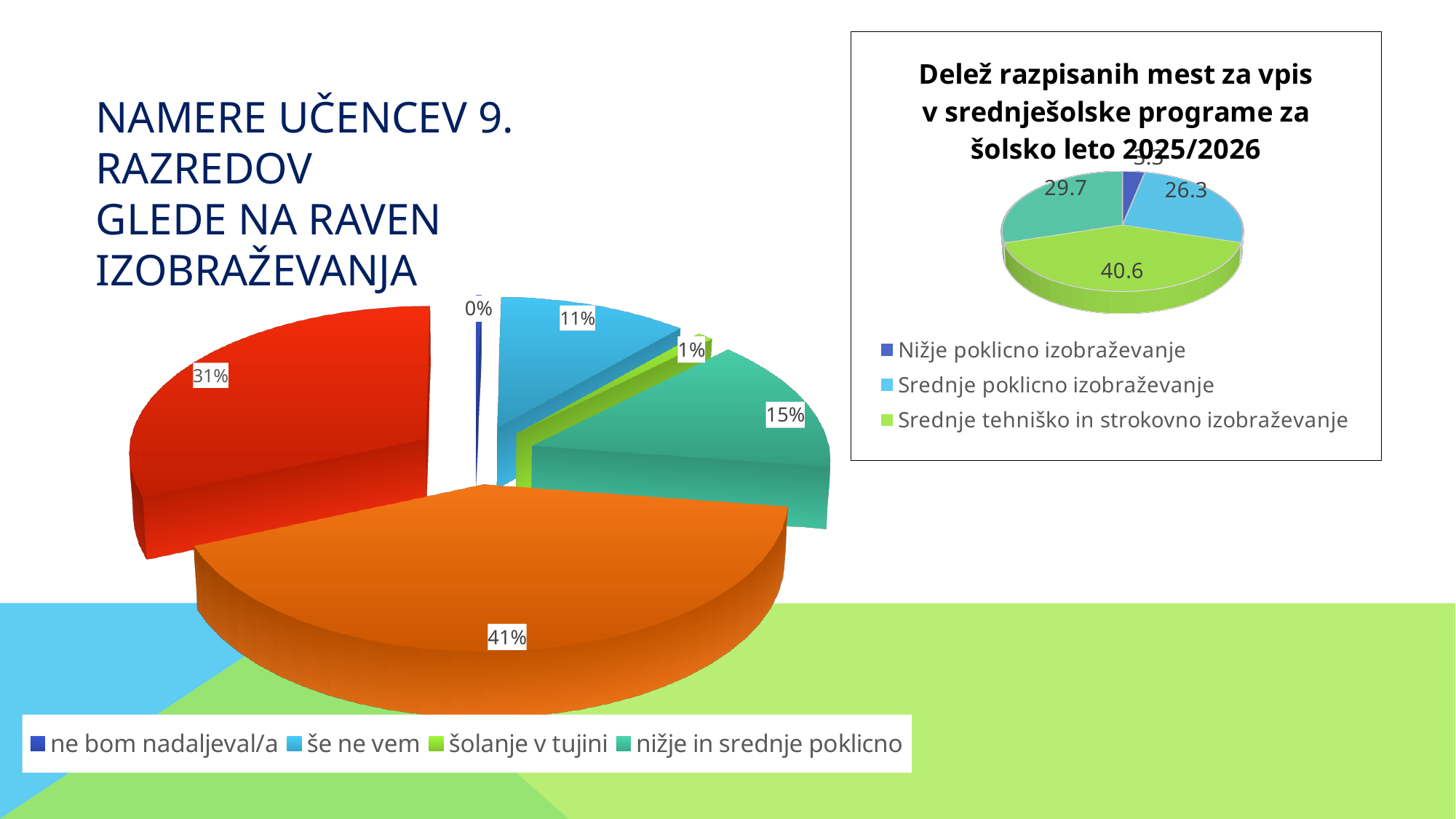
On the chart 'Delež razpisanih mest za vpis v srednješolske programe za šolsko leto 2025/2026', what value is shown for 'Srednje tehniško in strokovno izobraževanje'? 40.6 On the left chart (Namere učencev 9. razredov), what percentage is shown for 'ne bom nadaljeval/a'? 0% On the left chart (Namere učencev 9. razredov), what percentage is shown for 'še ne vem'? 11% What kind of chart is the chart titled 'Delež razpisanih mest za vpis v srednješolske programe za šolsko leto 2025/2026'? pie chart On the chart 'Delež razpisanih mest za vpis v srednješolske programe za šolsko leto 2025/2026', what value is shown for 'Srednje poklicno izobraževanje'? 26.3 On the left chart (Namere učencev 9. razredov), what is the difference between 'nižje in srednje poklicno' and 'še ne vem'? 4% On the left chart (Namere učencev 9. razredov), what is the percentage shown on the largest slice? 41% On the left chart (Namere učencev 9. razredov), what percentage is shown for 'nižje in srednje poklicno'? 15% On the left chart (Namere učencev 9. razredov), which is larger: 'še ne vem' or 'nižje in srednje poklicno'? nižje in srednje poklicno On the left chart (Namere učencev 9. razredov), how many entries does the legend list? 4 On the chart 'Delež razpisanih mest za vpis v srednješolske programe za šolsko leto 2025/2026', which legend category has the largest slice? Srednje tehniško in strokovno izobraževanje On the left chart (Namere učencev 9. razredov), what percentage is shown for 'šolanje v tujini'? 1%